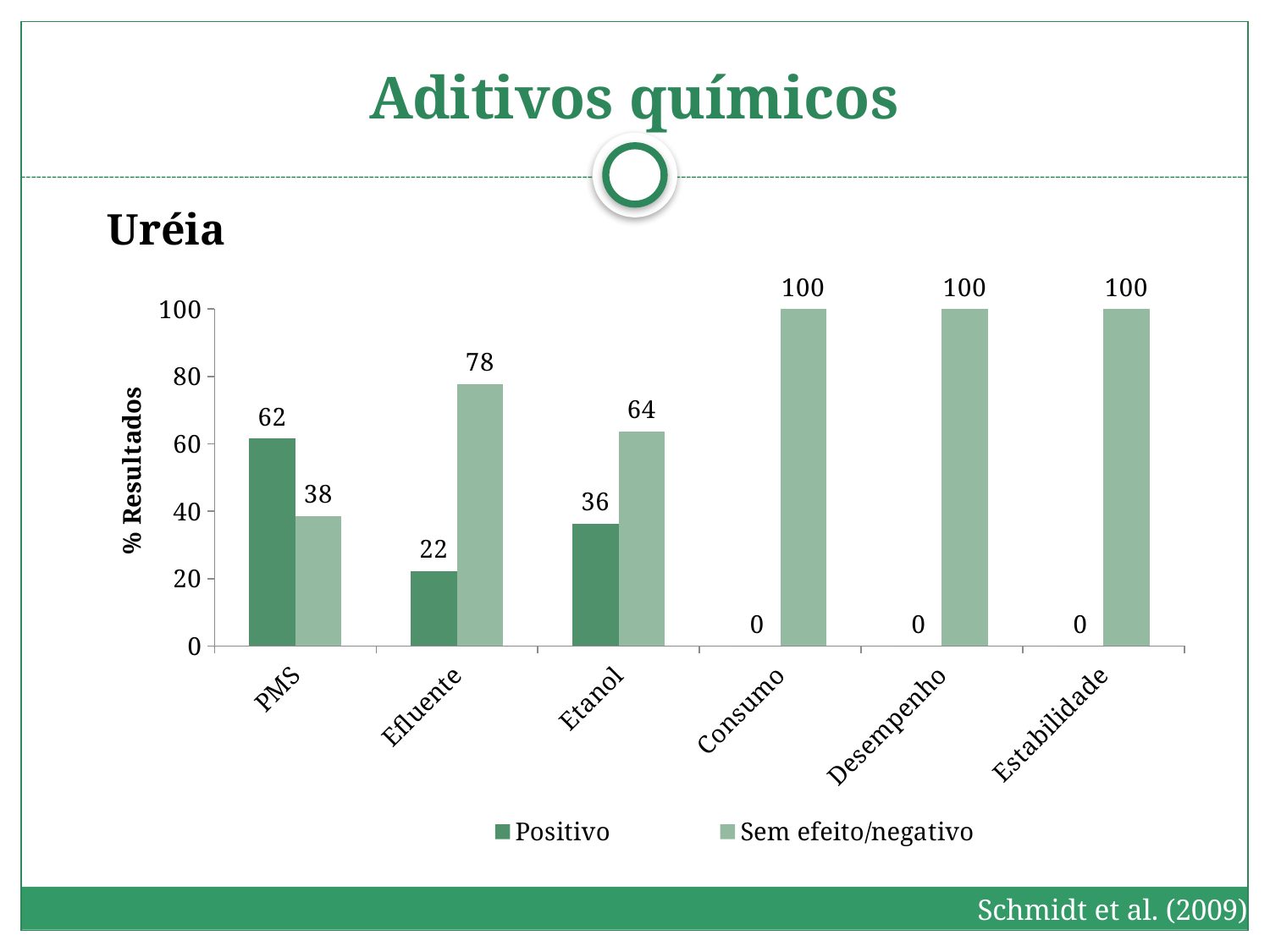
What is the Sem efeito/negativo value for Efluente? 78 What is the Positivo value for PMS? 62 Which category has the lowest Sem efeito/negativo value? PMS What is the Sem efeito/negativo value for Consumo? 100 How many categories are shown on the x axis? 6 What is the difference between the Sem efeito/negativo and Positivo values for Efluente? 56 What kind of chart is shown on the slide? Bar chart What is the label of the y axis? % Resultados Which is larger for Etanol: the Positivo value or the Sem efeito/negativo value? Sem efeito/negativo How many series does the legend list? 2 What is the Positivo value for Etanol? 36 Which category has the highest Positivo value? PMS